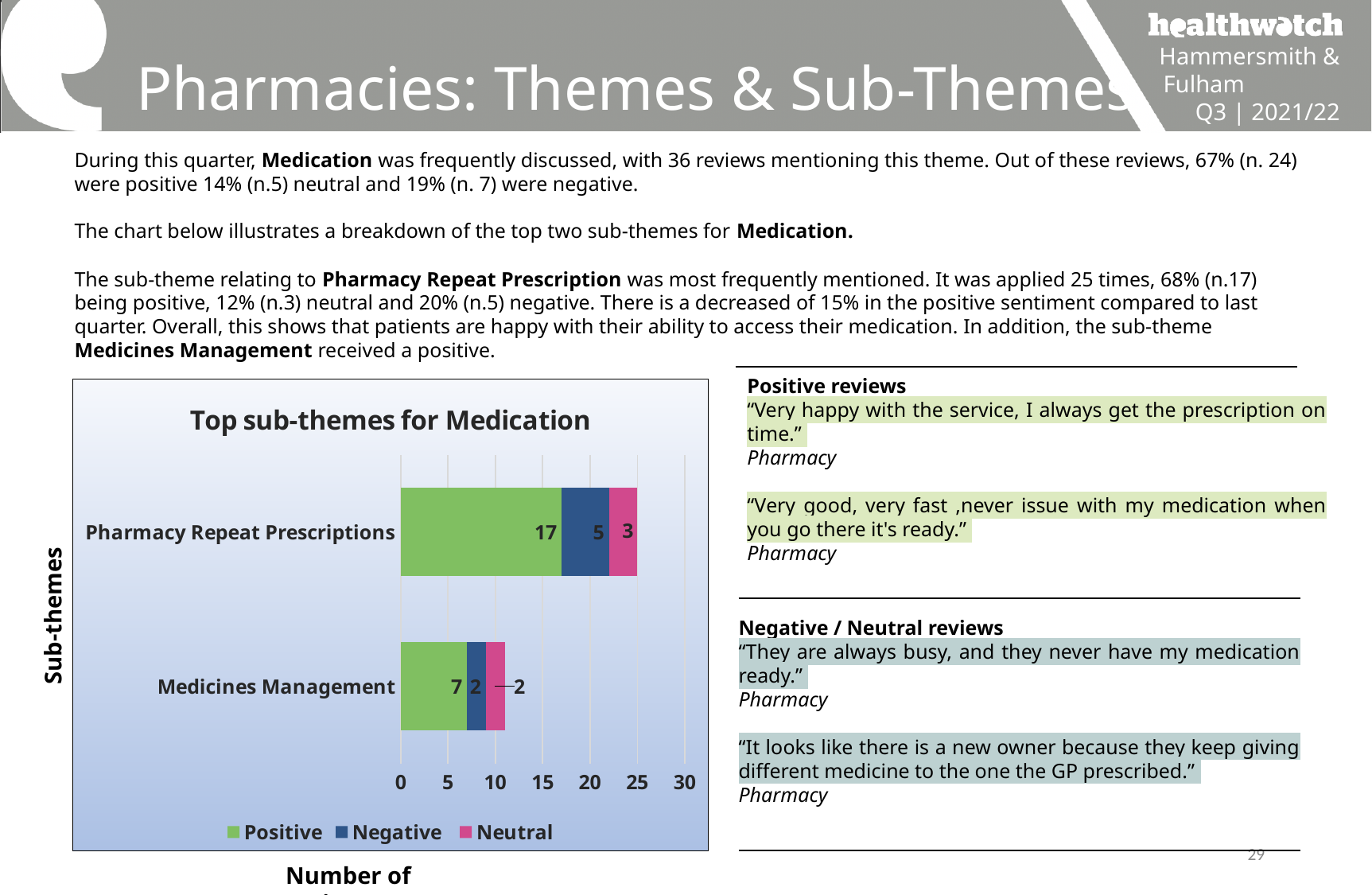
What type of chart is shown? Stacked bar chart What is the Positive value for Medicines Management? 7 What is the Positive value for Pharmacy Repeat Prescriptions? 17 What is the Neutral value for Pharmacy Repeat Prescriptions? 3 What is the total of the stacked bar for Medicines Management? 11 Is the Negative value larger for Pharmacy Repeat Prescriptions or Medicines Management? Pharmacy Repeat Prescriptions What is the Negative value for Medicines Management? 2 What is the difference between the Positive values for Pharmacy Repeat Prescriptions and Medicines Management? 10 How many series does the legend list? 3 Which sub-theme has the lowest Negative value? Medicines Management Which sub-theme has the highest Positive value? Pharmacy Repeat Prescriptions What is the total of the stacked bar for Pharmacy Repeat Prescriptions? 25